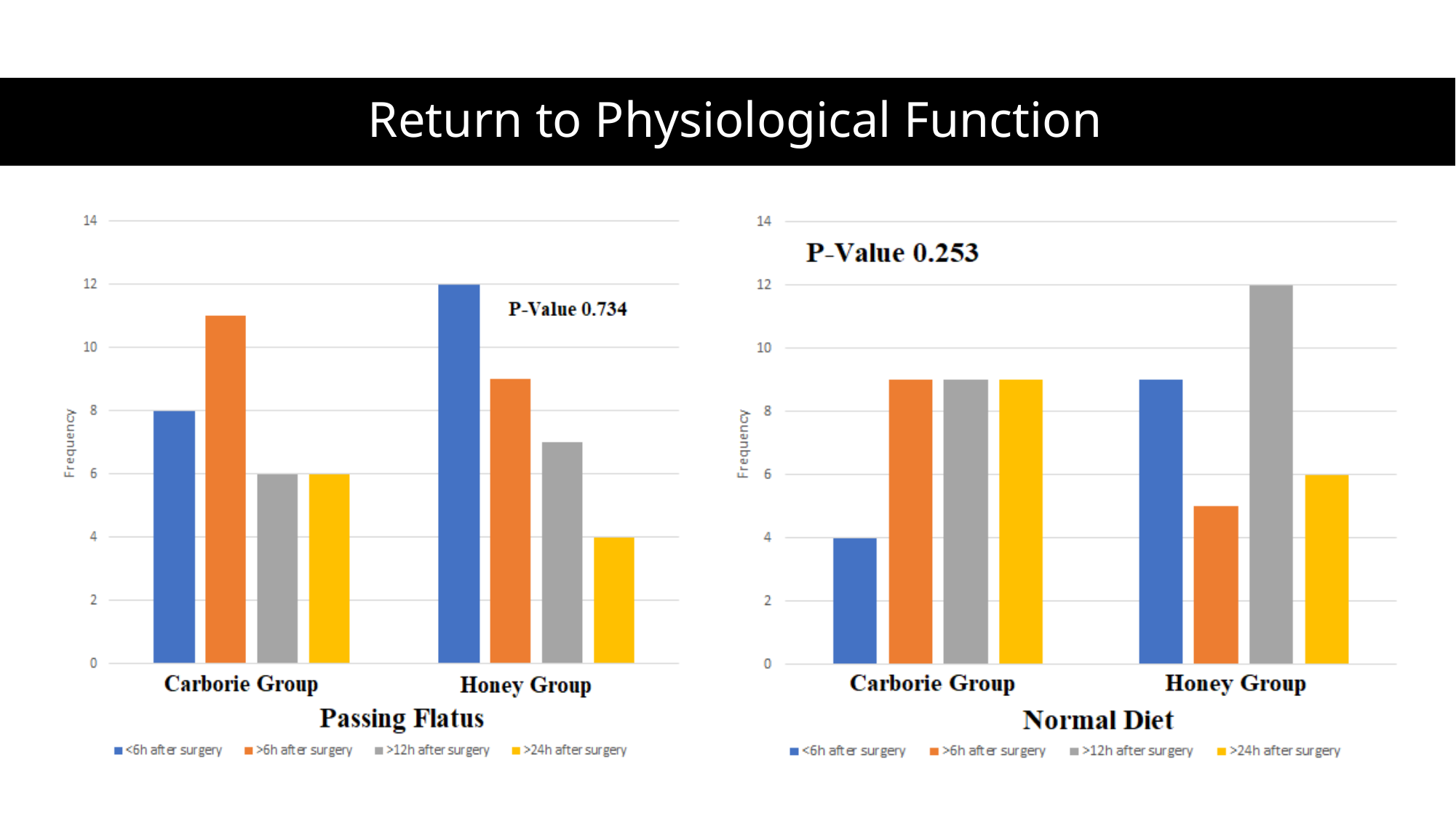
In the Passing Flatus chart, what is the frequency for >24h after surgery in the Honey Group? 4 What P-Value is shown on the Normal Diet chart? 0.253 What kind of chart is the Passing Flatus chart? bar chart In the Passing Flatus chart, is the value for >6h after surgery in the Carborie Group greater or less than 10? greater In the Passing Flatus chart, what is the frequency for <6h after surgery in the Honey Group? 12 In the Normal Diet chart, what is the frequency for <6h after surgery in the Carborie Group? 4 In the Passing Flatus chart, which series has the highest value in the Honey Group? <6h after surgery In the Normal Diet chart, what is the frequency for >12h after surgery in the Honey Group? 12 In the Normal Diet chart, which series has the lowest value in the Carborie Group? <6h after surgery How many series does the legend of the Passing Flatus chart list? 4 In the Passing Flatus chart, what is the frequency for <6h after surgery in the Carborie Group? 8 In the Normal Diet chart, is the value for >6h after surgery in the Honey Group greater or less than 6? less